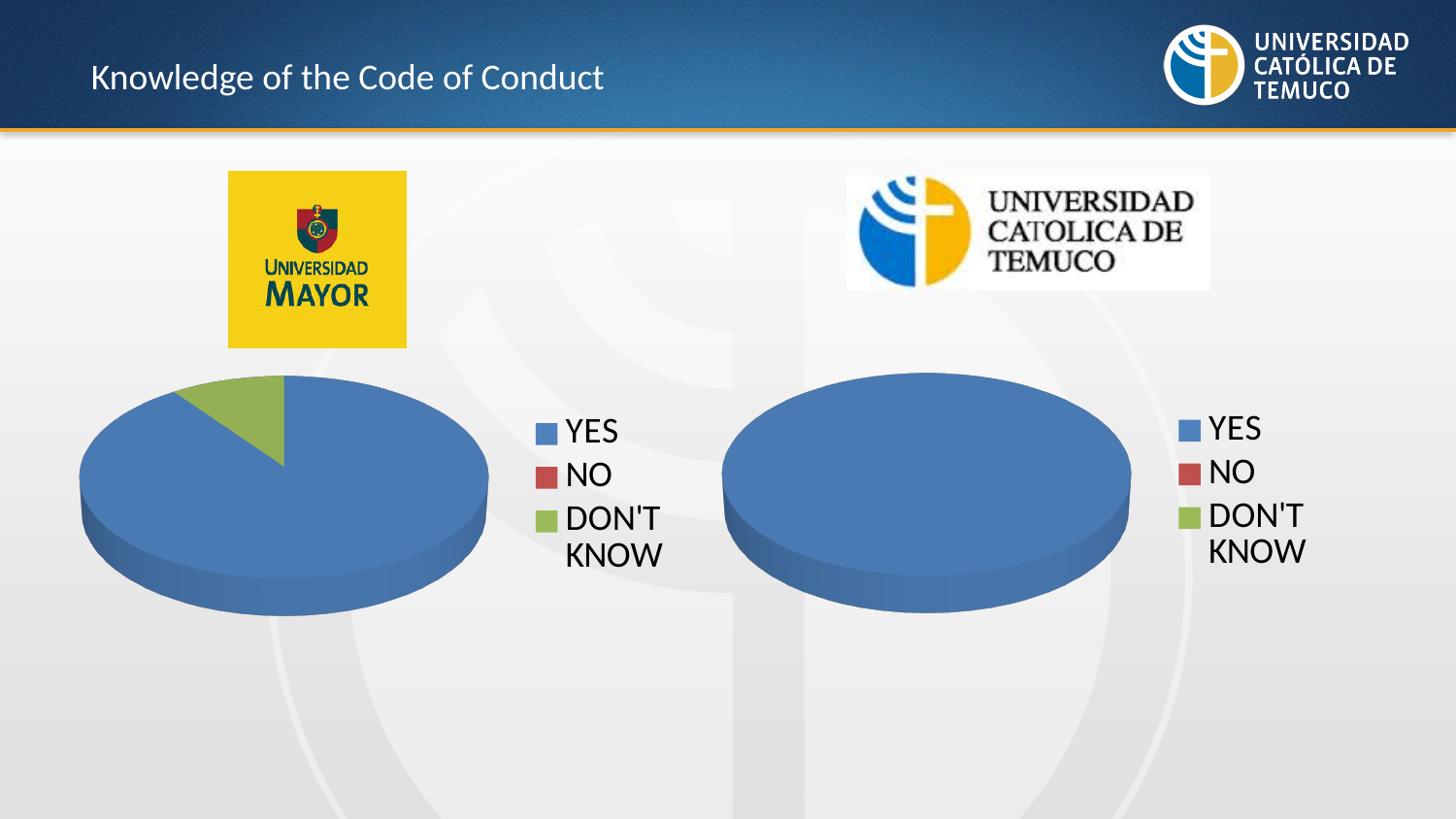
How many slices are visible in the left pie chart (Universidad Mayor)? 2 What kind of chart is shown on the left side of the slide, under the Universidad Mayor logo? pie chart In the left pie chart (Universidad Mayor), which category has the largest slice? YES In the left pie chart (Universidad Mayor), which category is shown in green? DON'T KNOW In the left pie chart (Universidad Mayor), which is larger, the YES slice or the DON'T KNOW slice? YES In the left pie chart (Universidad Mayor), which category has the smallest visible slice? DON'T KNOW What kind of chart is shown on the right side of the slide, under the Universidad Católica de Temuco logo? pie chart How many entries does the legend of the left pie chart (Universidad Mayor) list? 3 How many entries does the legend of the right pie chart (Universidad Católica de Temuco) list? 3 In the right pie chart (Universidad Católica de Temuco), which category has the largest slice? YES In the right pie chart (Universidad Católica de Temuco), which category is shown in blue? YES How many slices are visible in the right pie chart (Universidad Católica de Temuco)? 1